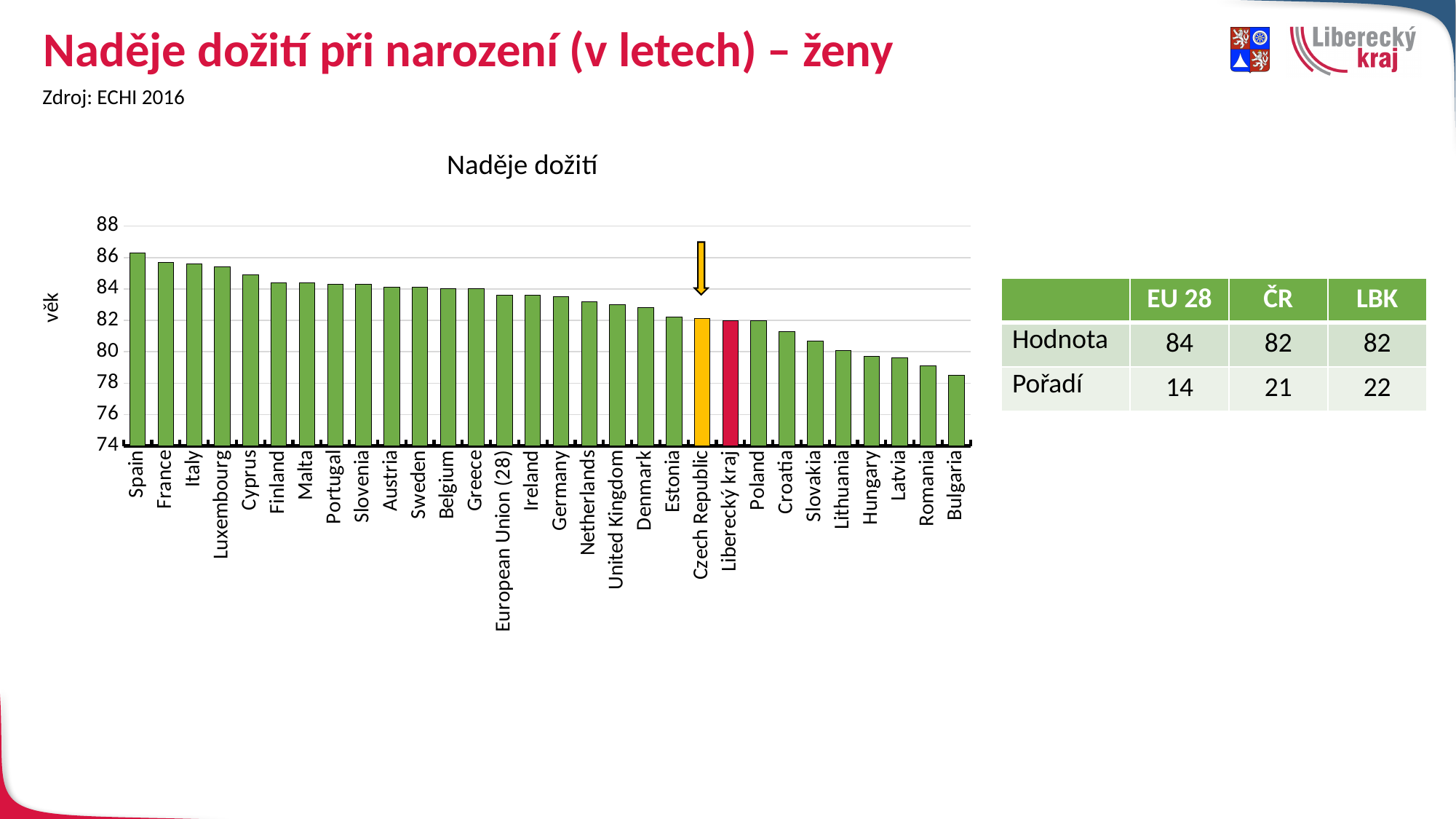
Which has the larger value, France or Romania? France Is the value for Bulgaria greater or less than 80? less Which has the larger value, Hungary or Austria? Austria Is the value for Spain greater or less than 84? greater Which country has the highest life expectancy in the chart? Spain What is the title of the chart? Naděje dožití Which country has the lowest life expectancy in the chart? Bulgaria Is the value for Poland greater or less than 84? less How many bars (categories) are plotted in the chart? 30 Do the values rise or fall from left to right along the x axis? fall What kind of chart is shown on the slide? bar chart